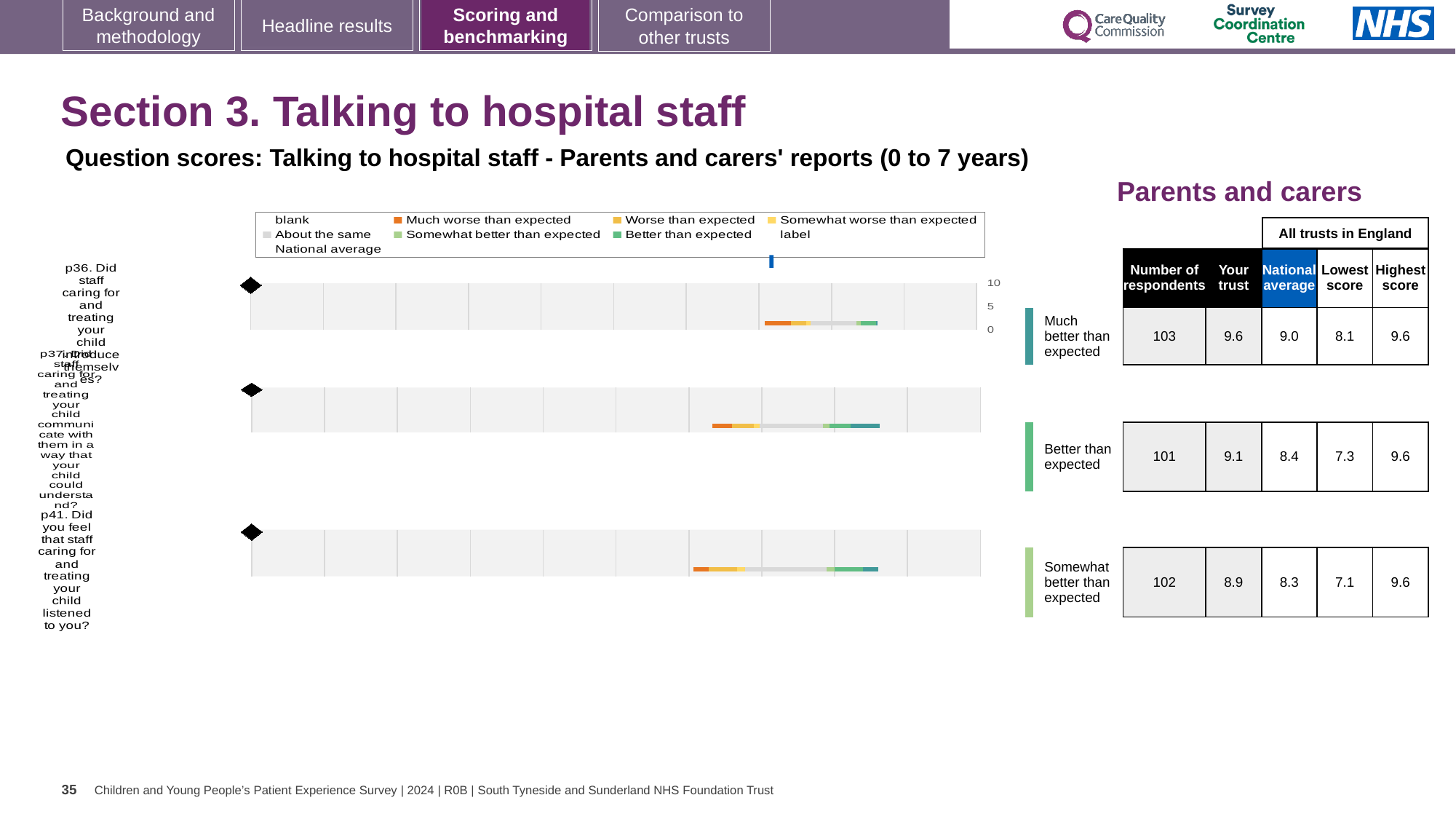
In the table beside the chart, what is the 'Your trust' score for the row labelled 'Better than expected'? 9.1 In the table beside the chart, what is the number of respondents for the row labelled 'Much better than expected'? 103 How many survey questions (bars) are plotted in the chart? 3 What colour does the legend use for 'Much worse than expected'? orange In the table beside the chart, what is the national average for the row labelled 'Somewhat better than expected'? 8.3 Which row in the table beside the chart has the lowest 'Lowest score' value? Somewhat better than expected In the table beside the chart, for the row labelled 'Better than expected', which is larger: the 'Your trust' score or the national average? Your trust Which row in the table beside the chart has the highest 'Your trust' score? Much better than expected What kind of chart is shown on the slide? bar chart What is the heading above the table to the right of the chart? Parents and carers In the table beside the chart, what is the lowest score for the row labelled 'Much better than expected'? 8.1 In the table beside the chart, what is the difference between the 'Your trust' score and the national average for the row labelled 'Much better than expected'? 0.6